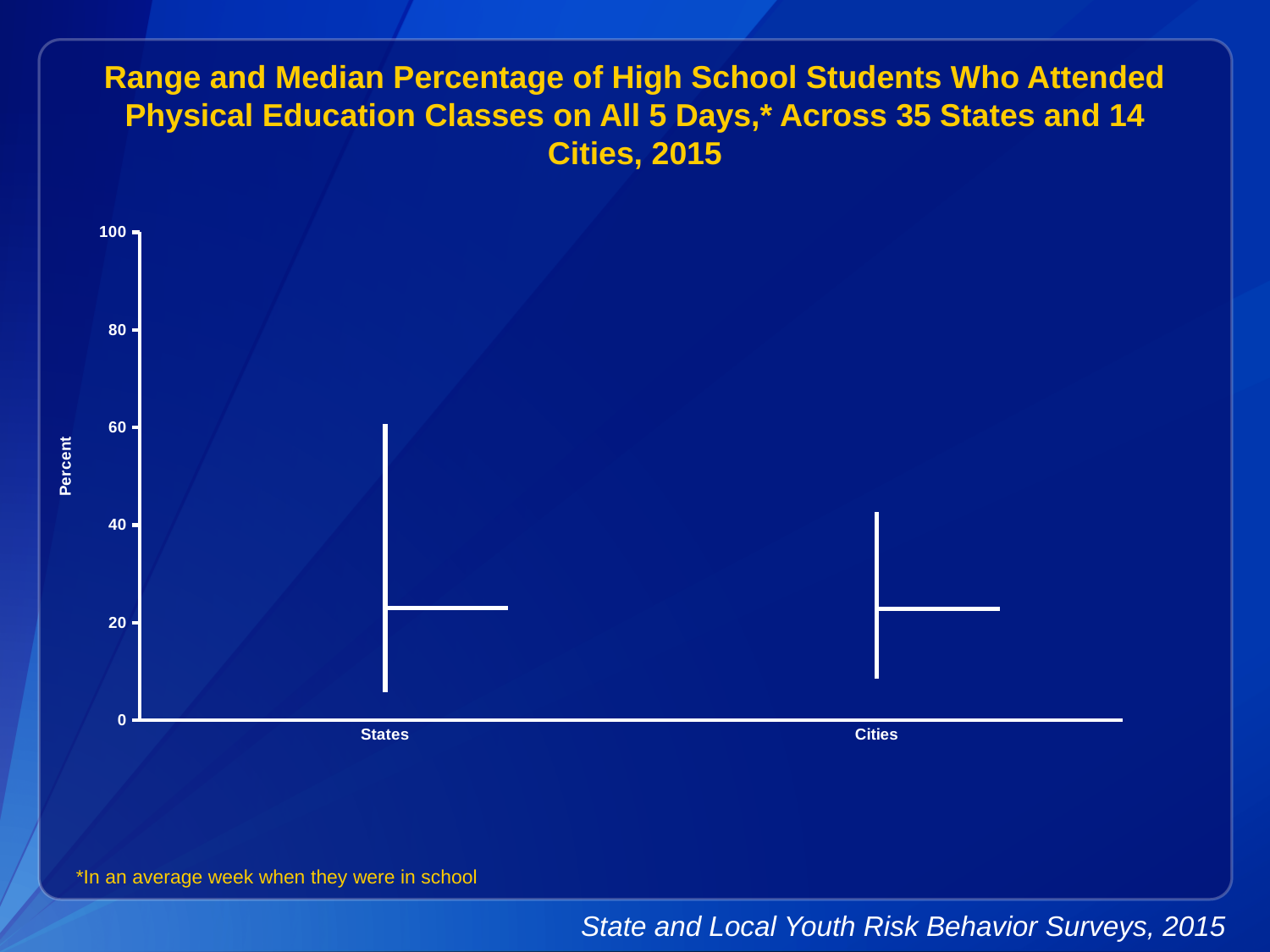
Which category has the wider range of values? States Is the bottom of the range for States greater or less than 20? less Is the median value for Cities greater or less than 40? less Is the top of the range for States greater or less than 40? greater What is the highest value shown on the vertical axis? 100 How many categories are shown on the x axis of the chart? 2 Which category has the higher top of its range, States or Cities? States What is the label on the vertical axis of the chart? Percent What are the two categories shown on the x axis? States and Cities